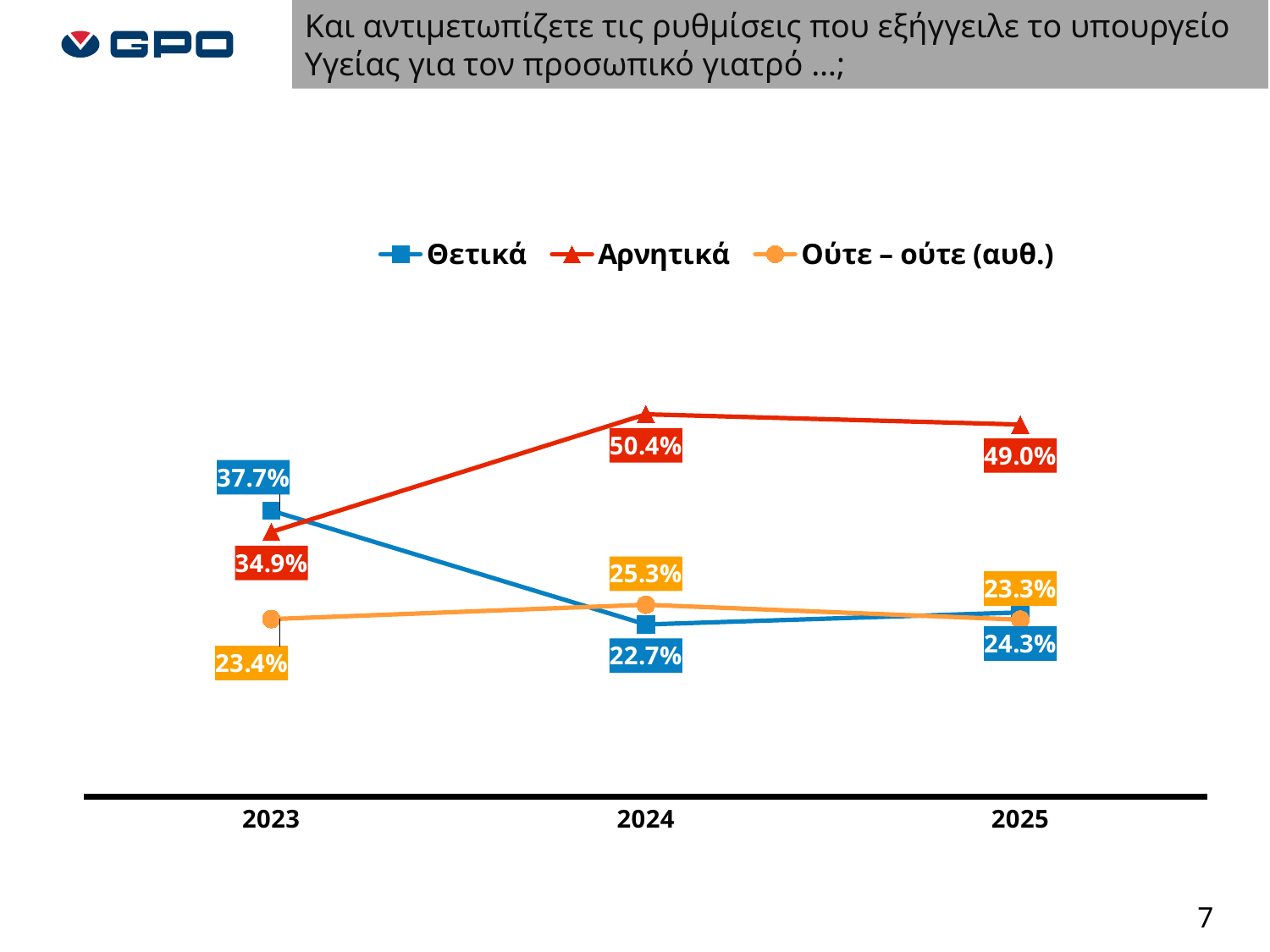
What is the value for Ούτε – ούτε (αυθ.) in 2025? 23.3% What is the difference between the Αρνητικά values in 2024 and 2025? 1.4% Which is larger in 2023, Θετικά or Αρνητικά? Θετικά In which year is the Αρνητικά series highest? 2024 What kind of chart is shown on the slide? Line chart How many series does the legend list? 3 What is the value for Αρνητικά in 2024? 50.4% What is the value for Θετικά in 2025? 24.3% In which year is the Θετικά series lowest? 2024 Does the Θετικά series rise or fall from 2023 to 2024? Fall What is the difference between Αρνητικά and Θετικά in 2024? 27.7% What is the value for Θετικά in 2023? 37.7%